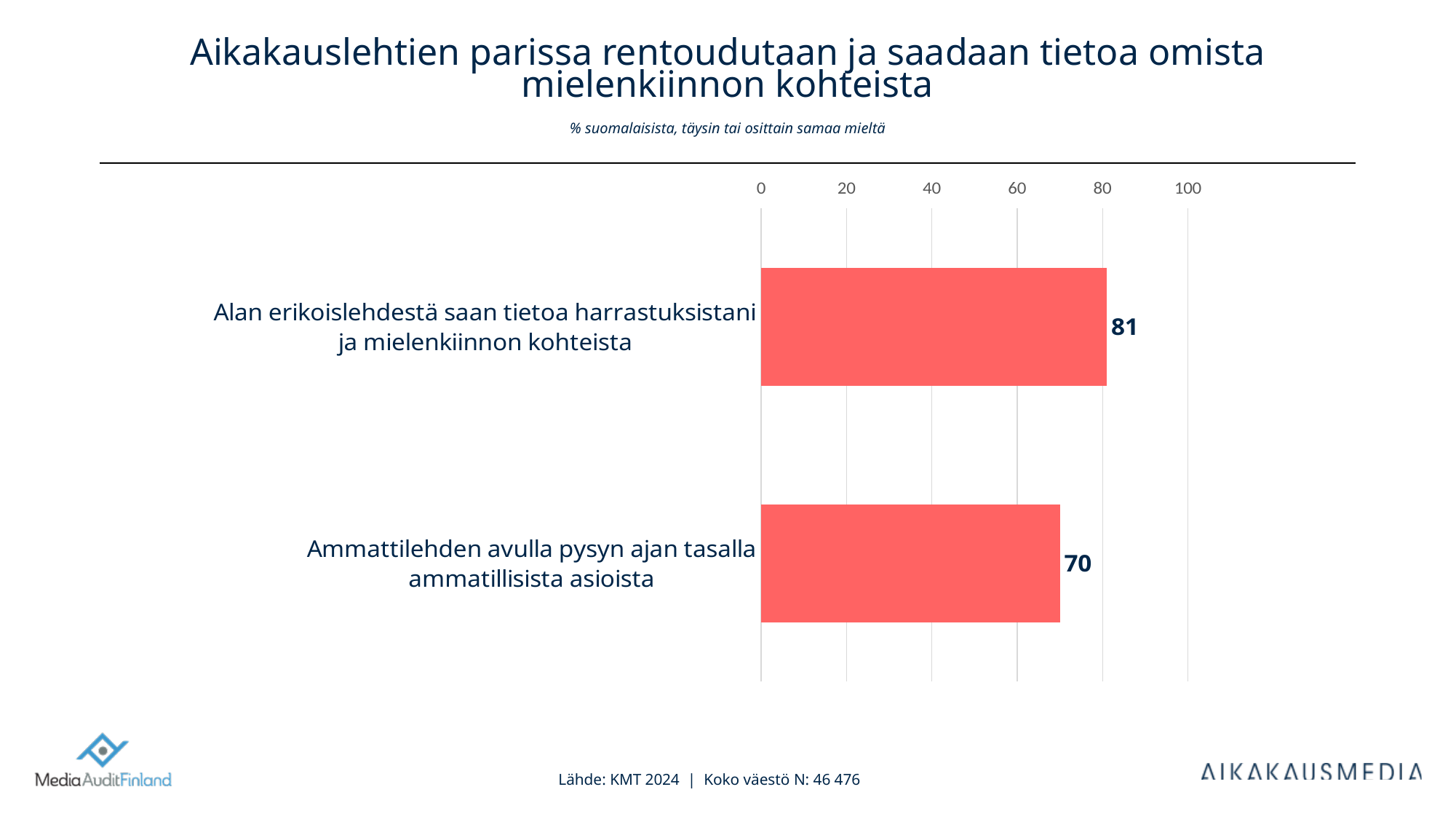
Is the value for "Alan erikoislehdestä saan tietoa harrastuksistani ja mielenkiinnon kohteista" greater or less than 80? greater What is the maximum value shown on the chart's axis? 100 Which is larger: the value for "Alan erikoislehdestä saan tietoa harrastuksistani ja mielenkiinnon kohteista" or the value for "Ammattilehden avulla pysyn ajan tasalla ammatillisista asioista"? Alan erikoislehdestä saan tietoa harrastuksistani ja mielenkiinnon kohteista How many categories are shown in the chart? 2 What is the subtitle shown below the slide title? % suomalaisista, täysin tai osittain samaa mieltä What kind of chart is shown on the slide? Bar chart Which category has the highest value? Alan erikoislehdestä saan tietoa harrastuksistani ja mielenkiinnon kohteista What is the value for "Alan erikoislehdestä saan tietoa harrastuksistani ja mielenkiinnon kohteista"? 81 Which category has the lowest value? Ammattilehden avulla pysyn ajan tasalla ammatillisista asioista What is the value for "Ammattilehden avulla pysyn ajan tasalla ammatillisista asioista"? 70 What is the difference between the values for "Alan erikoislehdestä saan tietoa harrastuksistani ja mielenkiinnon kohteista" and "Ammattilehden avulla pysyn ajan tasalla ammatillisista asioista"? 11 Is the value for "Ammattilehden avulla pysyn ajan tasalla ammatillisista asioista" greater or less than 80? less